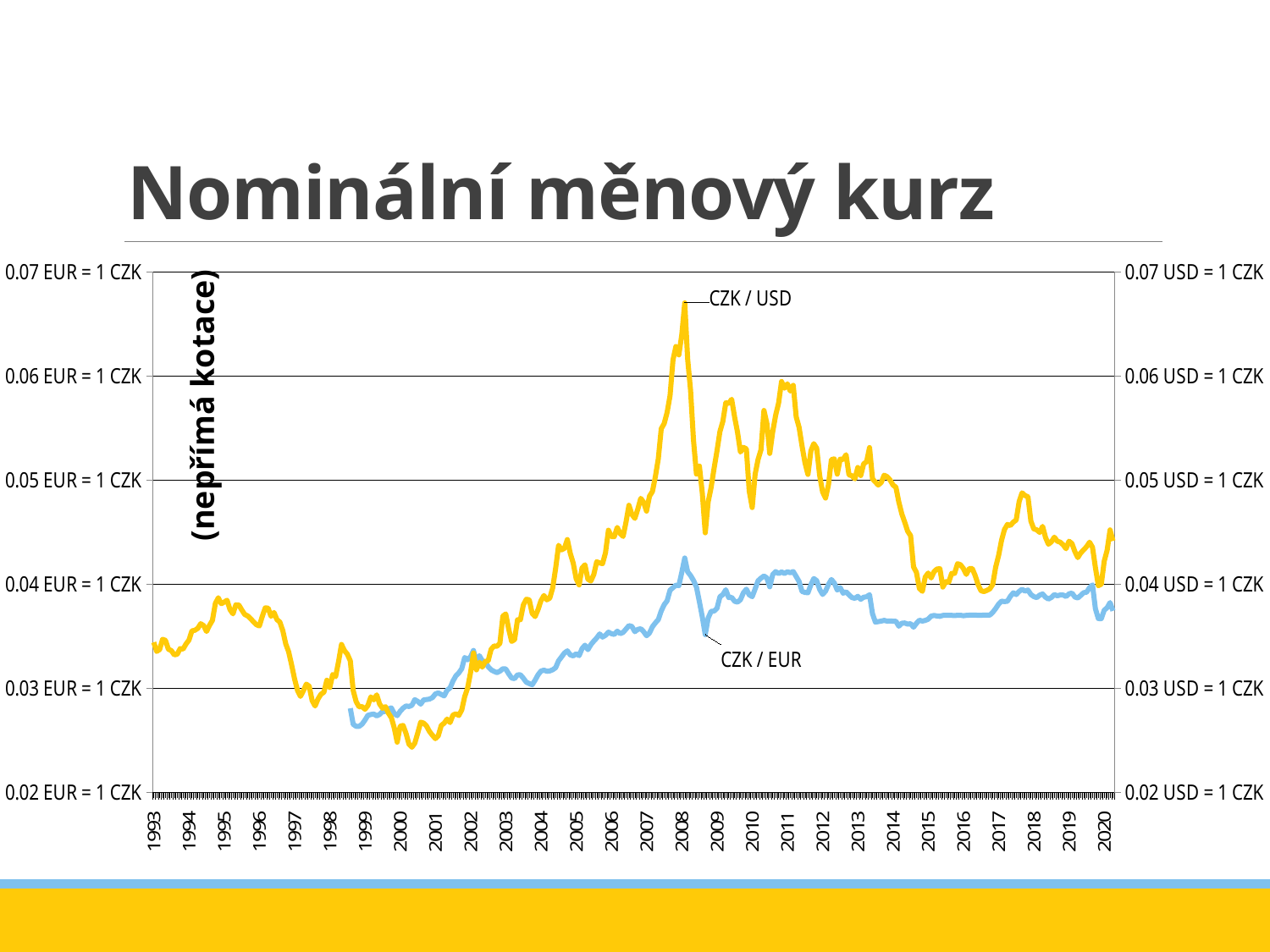
Which series reaches the highest value on the chart? CZK / USD Which colour is used for the CZK / USD line? yellow Does the CZK / USD line rise or fall between 2008 and 2015? fall Is the value of CZK / USD around 2011 greater or less than 0.05? greater How many series are plotted on the chart? 2 Is the peak value of CZK / USD around 2008 greater or less than 0.06? greater What is the title of the slide containing the chart? Nominální měnový kurz How many year labels are shown on the x axis? 28 Is the value of CZK / USD around 2000 greater or less than 0.03? less What kind of chart is shown on the slide? line chart Around 2010, which series has the higher value, CZK / USD or CZK / EUR? CZK / USD